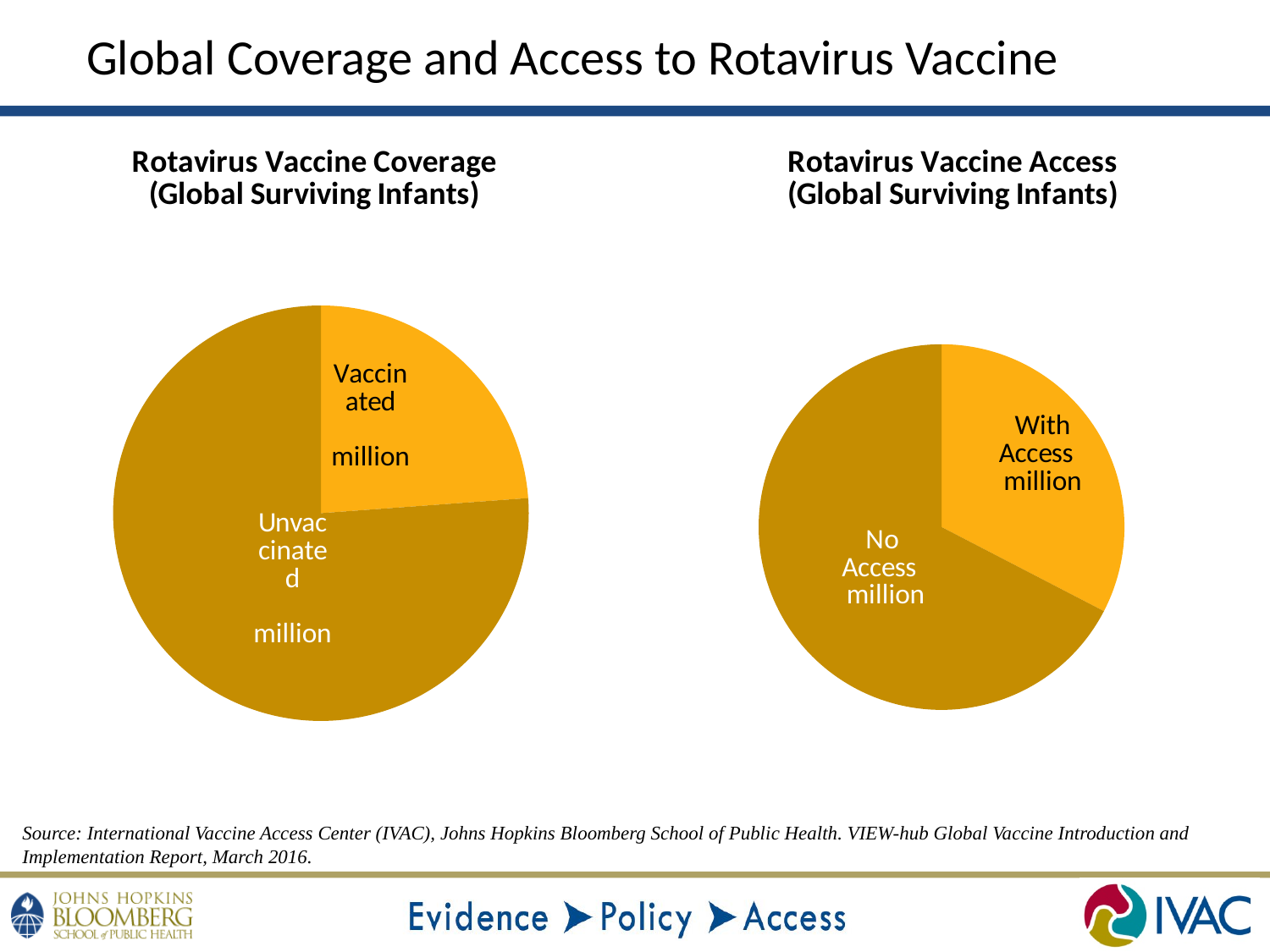
In the Rotavirus Vaccine Access chart, which slice is the largest? No Access How many slices does the Rotavirus Vaccine Access pie chart have? 2 In the Rotavirus Vaccine Coverage chart, which slice is larger, Vaccinated or Unvaccinated? Unvaccinated What kind of chart is the Rotavirus Vaccine Coverage chart on the left? Pie chart How many slices does the Rotavirus Vaccine Coverage pie chart have? 2 In the Rotavirus Vaccine Access chart, which slice is the smallest? With Access What kind of chart is the Rotavirus Vaccine Access chart on the right? Pie chart In the Rotavirus Vaccine Access chart, which slice is larger, With Access or No Access? No Access In the Rotavirus Vaccine Coverage chart, which slice is the smallest? Vaccinated What is the title of the pie chart on the left side of the slide? Rotavirus Vaccine Coverage (Global Surviving Infants) What is the title of the pie chart on the right side of the slide? Rotavirus Vaccine Access (Global Surviving Infants)